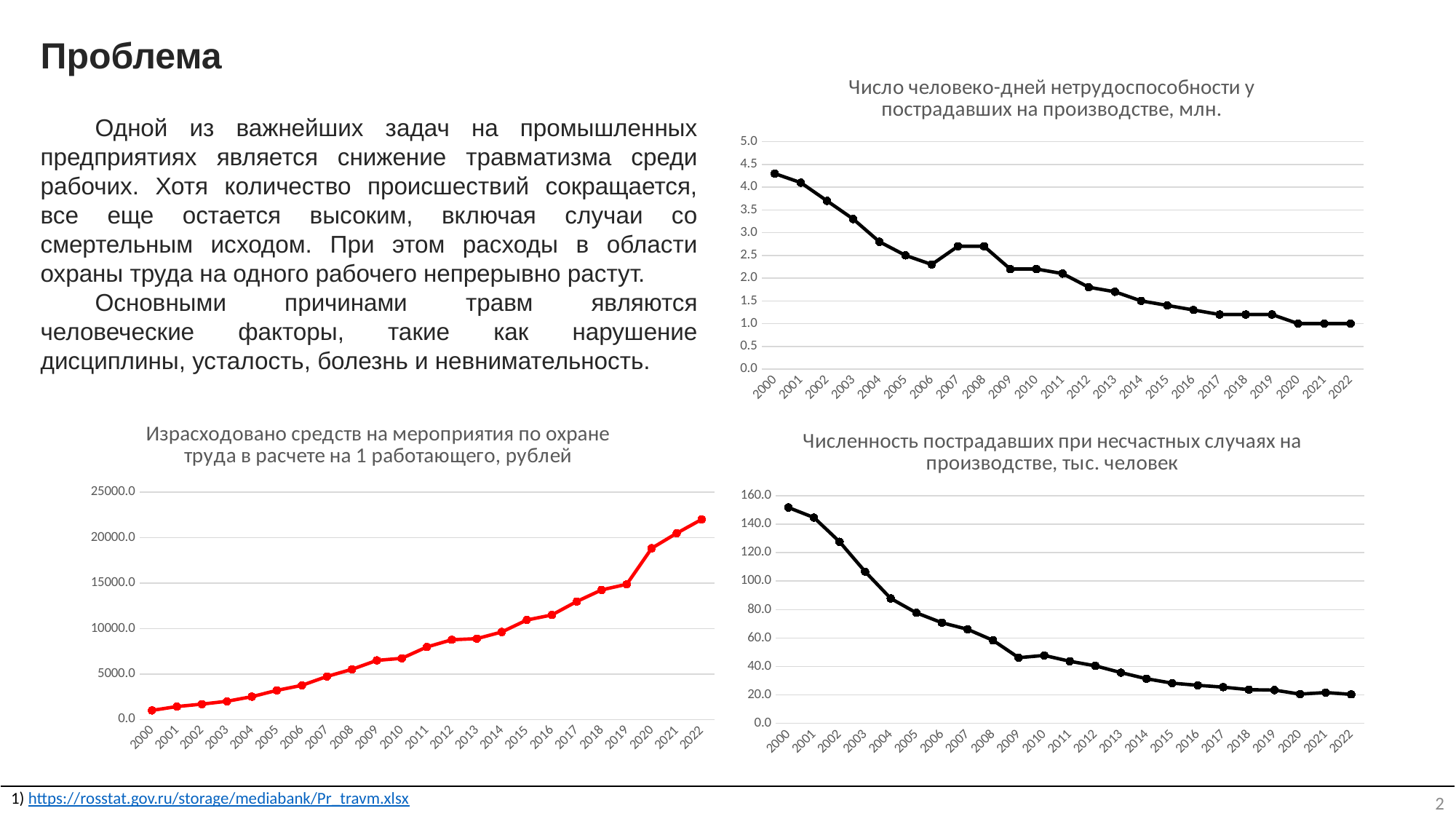
In the bottom-right chart "Численность пострадавших при несчастных случаях на производстве, тыс. человек", is the value for 2000 greater or less than 140.0? greater What kind of chart is the bottom-left chart titled "Израсходовано средств на мероприятия по охране труда в расчете на 1 работающего, рублей"? line chart In the top-right chart "Число человеко-дней нетрудоспособности у пострадавших на производстве, млн.", do the values rise or fall from 2000 to 2022? fall What colour is the line in the bottom-left chart "Израсходовано средств на мероприятия по охране труда в расчете на 1 работающего, рублей"? red In the bottom-left chart "Израсходовано средств на мероприятия по охране труда в расчете на 1 работающего, рублей", which year has the highest value? 2022 In the top-right chart "Число человеко-дней нетрудоспособности у пострадавших на производстве, млн.", which year has the larger value, 2006 or 2007? 2007 How many data points are plotted in the bottom-right chart "Численность пострадавших при несчастных случаях на производстве, тыс. человек"? 23 In the top-right chart "Число человеко-дней нетрудоспособности у пострадавших на производстве, млн.", is the value for 2010 greater or less than 2.5? less In the bottom-left chart "Израсходовано средств на мероприятия по охране труда в расчете на 1 работающего, рублей", do the values rise or fall from 2000 to 2022? rise In the bottom-left chart "Израсходовано средств на мероприятия по охране труда в расчете на 1 работающего, рублей", is the value for 2020 greater or less than 15000.0? greater In the top-right chart "Число человеко-дней нетрудоспособности у пострадавших на производстве, млн.", which year has the highest value? 2000 In the bottom-right chart "Численность пострадавших при несчастных случаях на производстве, тыс. человек", which year has the highest value? 2000